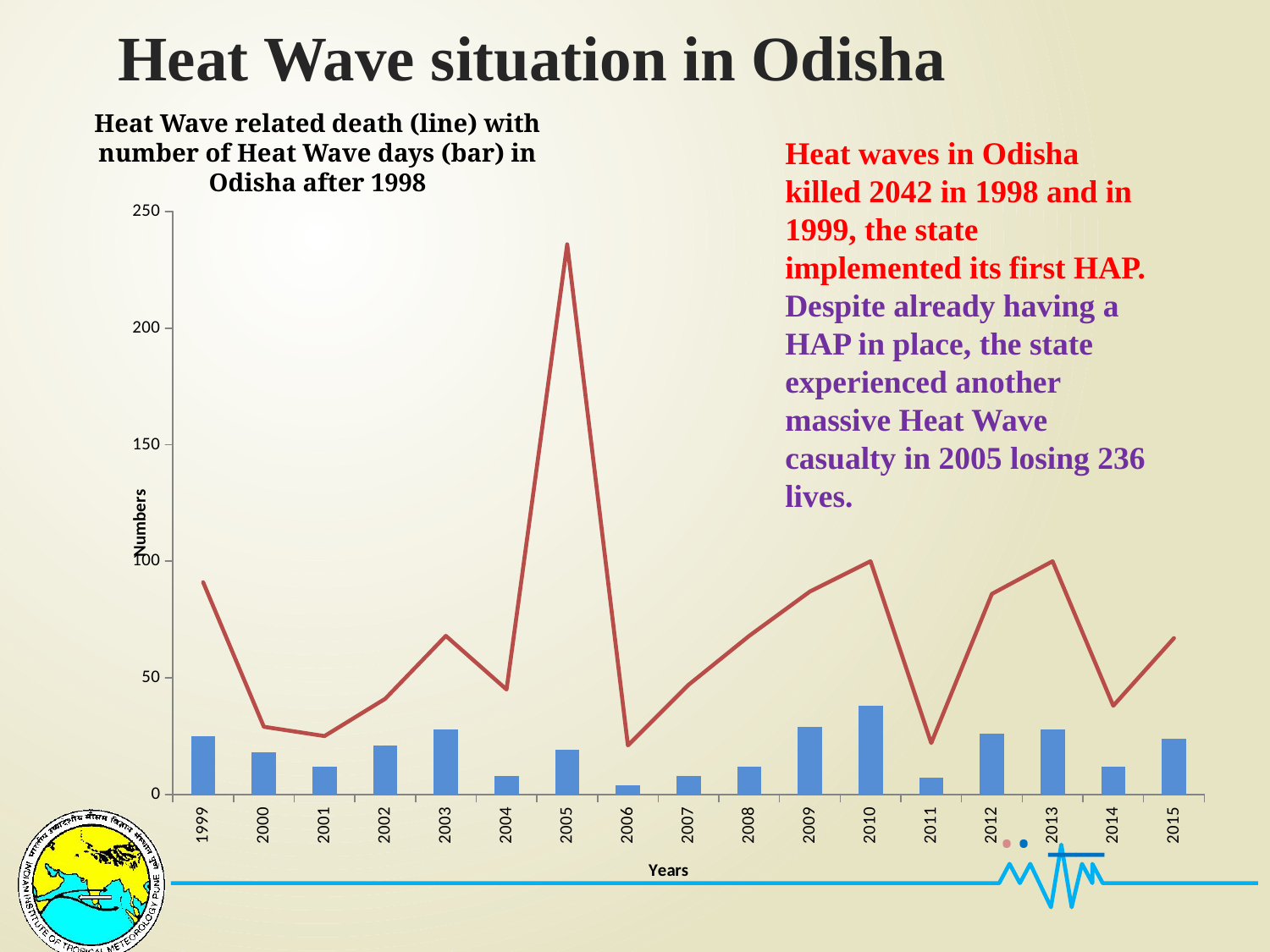
What is the label on the vertical axis of the chart? Numbers How many years are shown along the x axis of the chart? 17 Does the death line rise or fall between 2005 and 2006? It falls Is the bar value for 2010 greater or less than 50? less Which year has the shortest bar for number of heat wave days? 2006 Is the value of the death line for 2000 greater or less than 50? less Which year has the tallest bar for number of heat wave days? 2010 In which year does the heat wave death line reach its highest point? 2005 Is the value of the death line for 2005 greater or less than 200? greater What kind of chart is shown on the slide? A combined bar and line chart Which year has the higher value on the death line, 2012 or 2014? 2012